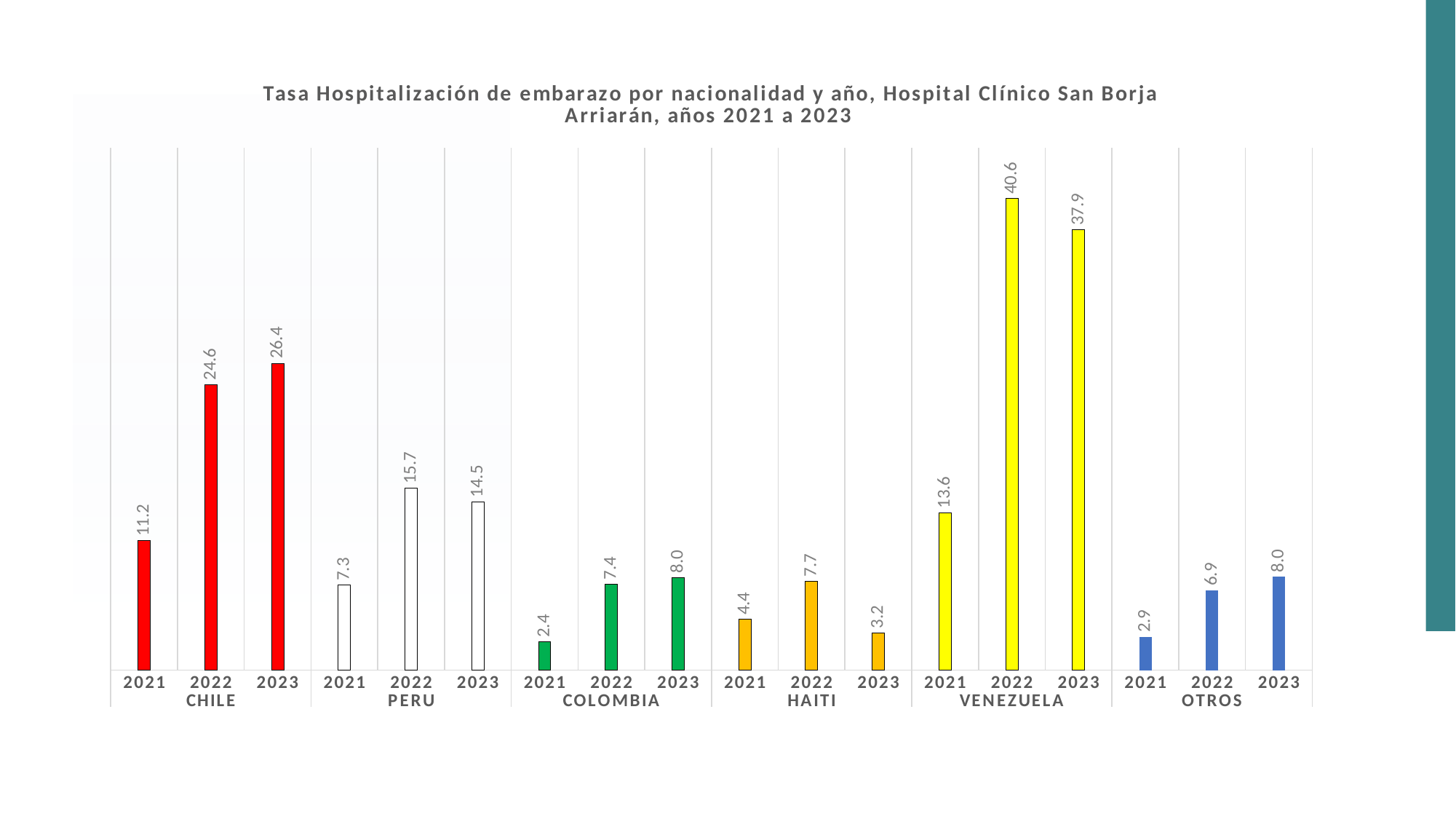
What is the value for Haiti in 2021? 4.4 Which is larger, the Colombia 2023 value or the Haiti 2022 value? Colombia 2023 What colour are the bars for Venezuela? Yellow What is the difference between the Chile 2022 and Chile 2021 values? 13.4 What is the value for Peru in 2022? 15.7 What kind of chart is this? Bar chart What is the value for Venezuela in 2022? 40.6 Do the values for Chile rise or fall from 2021 to 2023? Rise Which country and year has the highest bar on the chart? Venezuela 2022 What is the hospitalization rate for Chile in 2023? 26.4 Which country and year has the lowest bar on the chart? Colombia 2021 How many countries (nationality groups) are shown on the x axis? 6